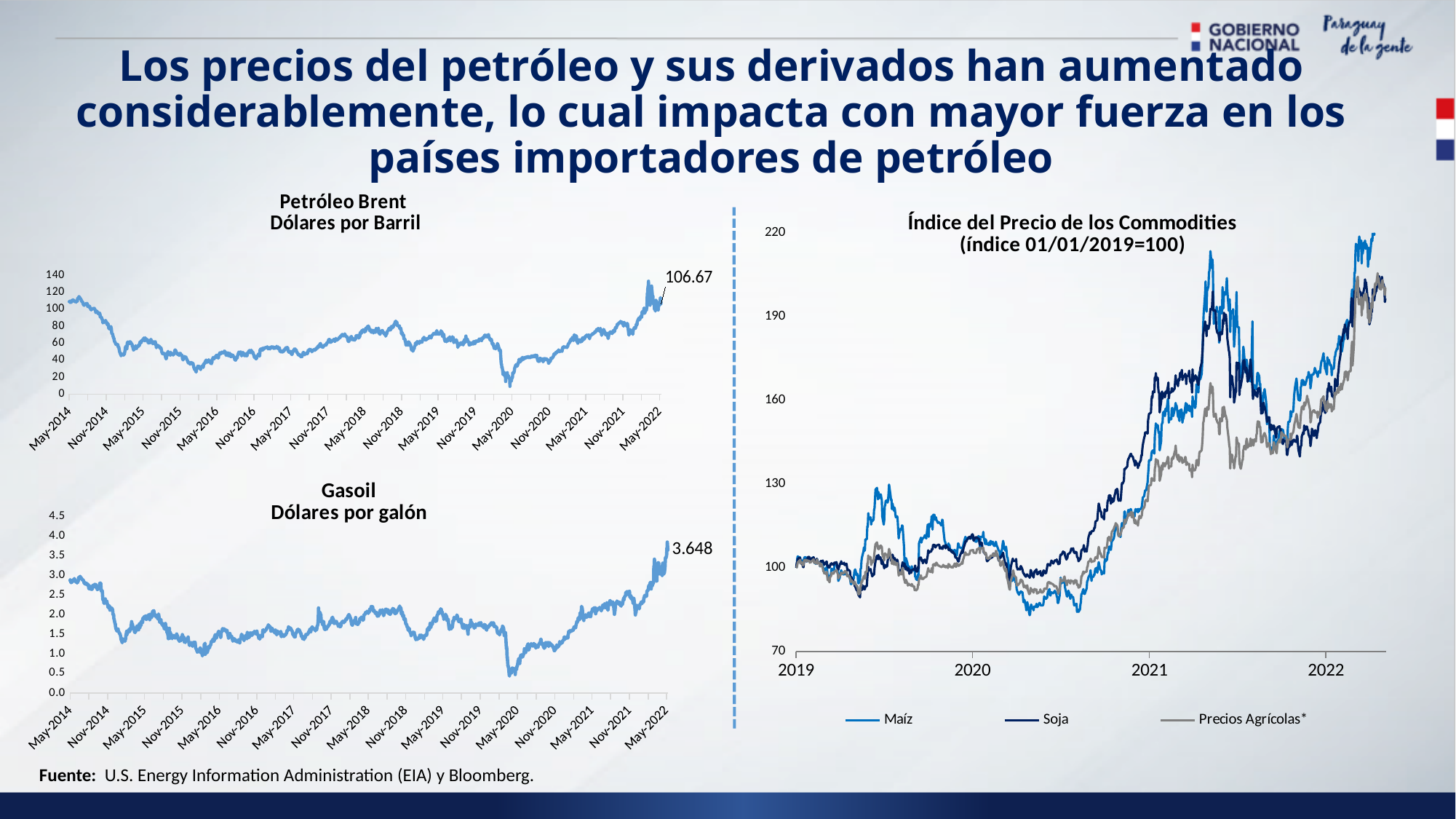
In the Petróleo Brent chart, is the value at the low point around May-2020 greater or less than 40? less In the Gasoil chart, is the value at the low point around May-2020 greater or less than 1.0? less What kind of chart is the Petróleo Brent chart? line chart In the Índice del Precio de los Commodities chart, do the series overall rise or fall from 2019 to 2022? rise In the Petróleo Brent chart, what is the value printed at the end of the series (May-2022)? 106.67 How many series does the legend of the Índice del Precio de los Commodities chart list? 3 In the Índice del Precio de los Commodities chart, around mid-2021, which series is higher, Maíz or Precios Agrícolas*? Maíz In the Gasoil chart, what is the value printed at the end of the series (May-2022)? 3.648 In the Índice del Precio de los Commodities chart, is the Maíz value at the end of the series in 2022 greater or less than 190? greater What is the first date label on the x axis of the Gasoil chart? May-2014 What are the legend entries of the Índice del Precio de los Commodities chart? Maíz, Soja, Precios Agrícolas*